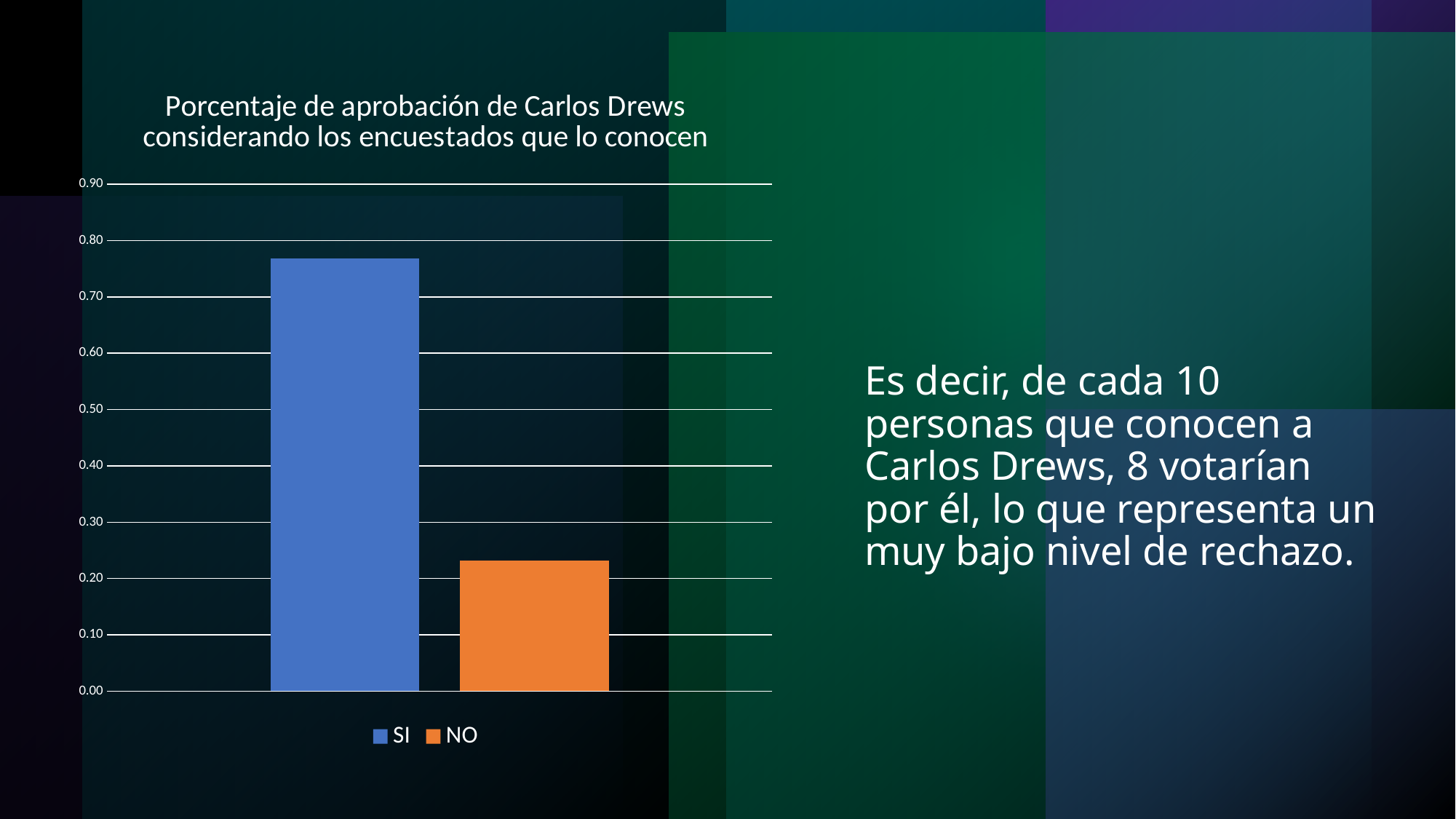
What colour is the bar for the NO series? Orange What kind of chart is shown on the slide? Bar chart Is the value for SI greater or less than 0.70? greater What is the title of the chart? Porcentaje de aprobación de Carlos Drews considerando los encuestados que lo conocen Is the value for NO greater or less than 0.30? less Is the value for SI greater or less than 0.80? less How many series does the chart legend list? 2 Which series has the highest bar in the chart? SI How many bars are plotted in the chart? 2 Which is larger, the value for SI or the value for NO? SI Which series has the lowest bar in the chart? NO